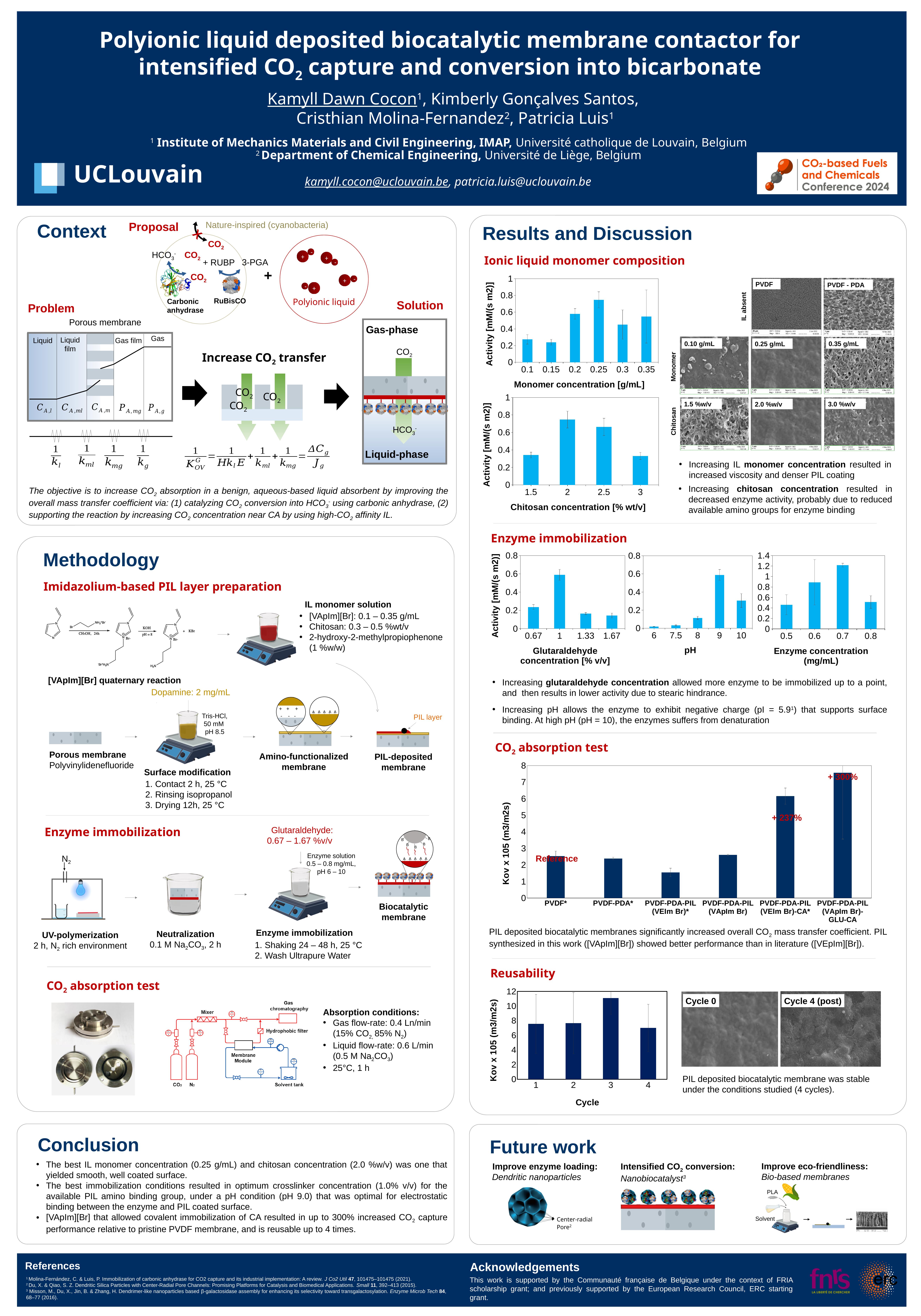
In the chart of activity versus monomer concentration, which monomer concentration gives the highest activity? 0.25 In the chart of activity versus pH, which pH gives the highest activity? 9 In the chart of activity versus enzyme concentration, which enzyme concentration gives the highest activity? 0.7 In the chart of activity versus monomer concentration, how many monomer concentrations are plotted? 6 In the chart of activity versus enzyme concentration, is the activity at 0.7 mg/mL greater or less than 1? greater In the CO2 absorption test chart, what percentage increase is labelled on the PVDF-PDA-PIL (VApIm Br)-GLU-CA bar? + 300% In the CO2 absorption test chart, which membrane has the lowest Kov value? PVDF-PDA-PIL (VEIm Br)* In the chart of activity versus pH, which pH gives the lowest activity? 6 In the chart of activity versus chitosan concentration, is the activity at 2 % wt/v greater or less than 0.6? greater